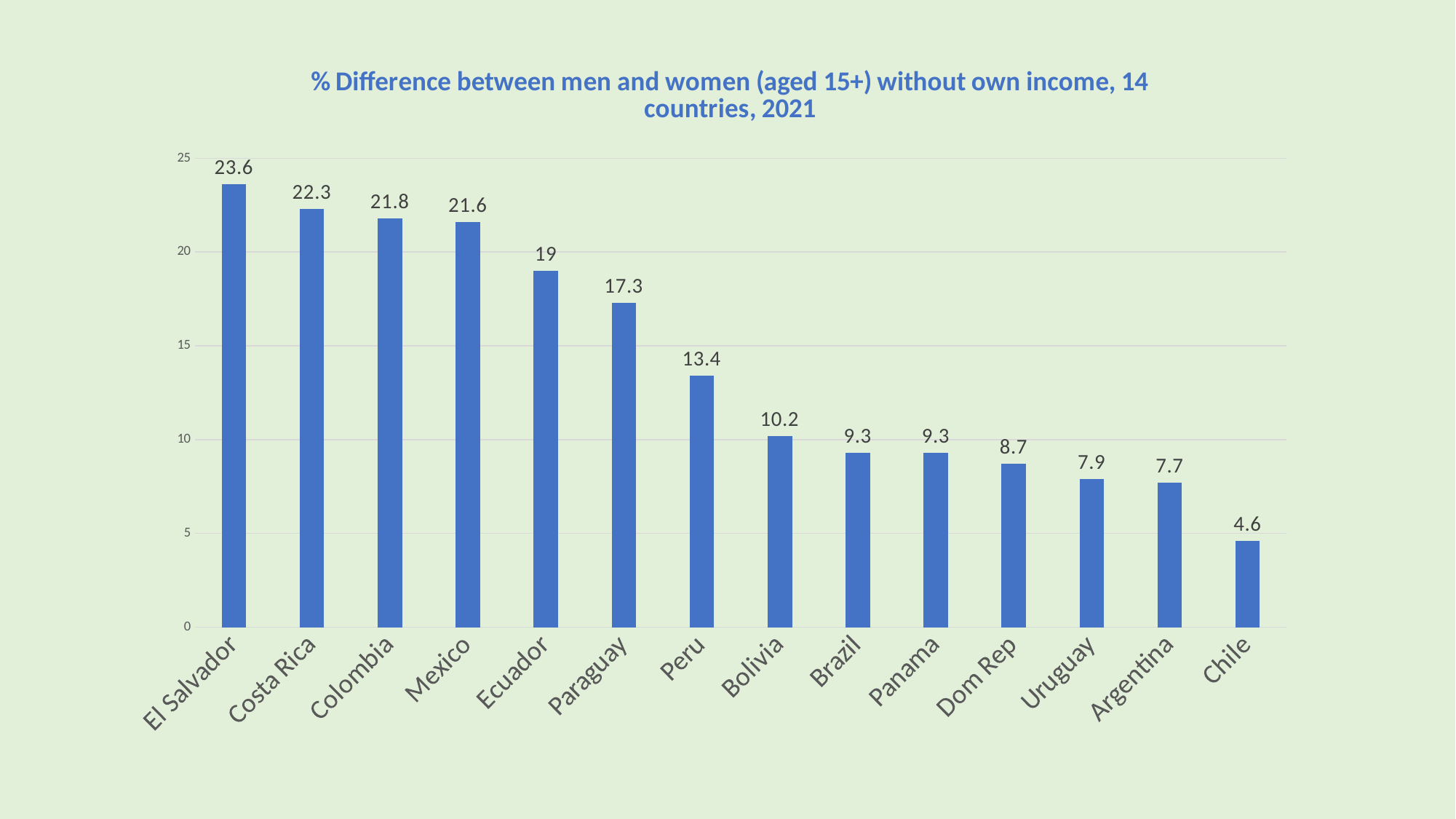
Which has a larger value, Bolivia or Uruguay? Bolivia What is the difference between the values for El Salvador and Chile? 19 Which country has the highest value? El Salvador What is the value for Peru? 13.4 What kind of chart is shown on the slide? Bar chart How many countries are shown in the chart? 14 Which country has the lowest value? Chile Do the values rise or fall from left to right along the x axis? Fall Is the value for Paraguay greater or less than 15? greater What is the value for Dom Rep? 8.7 What is the difference between the values for Ecuador and Paraguay? 1.7 What is the value for Mexico? 21.6